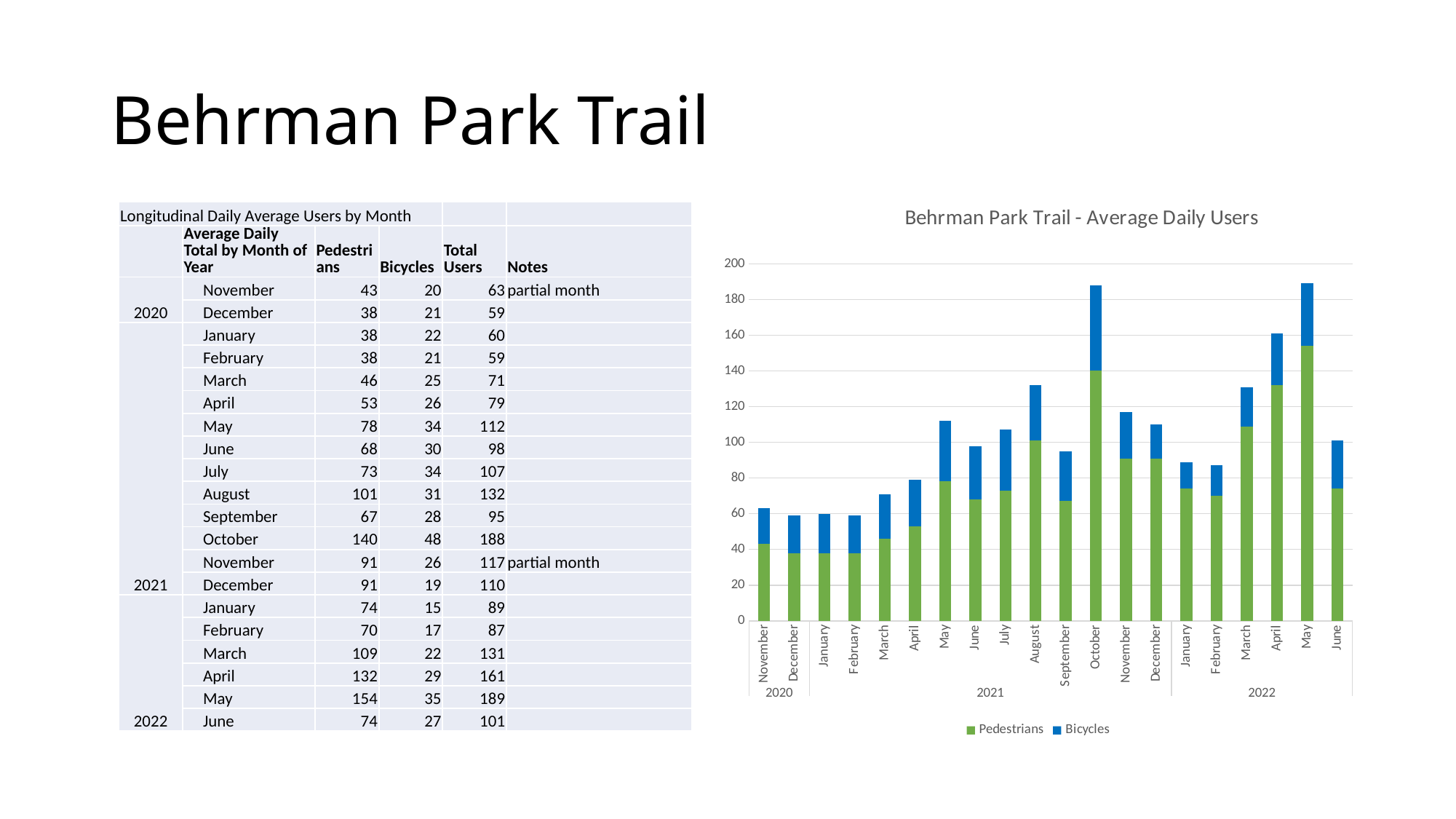
How many series does the chart legend list? 2 Is the total for September 2021 greater or less than 100? less Which month has the highest Pedestrians value in the chart? May 2022 Which is larger, the total for April 2022 or the total for November 2021? April 2022 What kind of chart is shown on the slide? stacked bar chart What is the difference between the Pedestrians values for October 2021 and September 2021? 73 What is the total average daily users for October 2021? 188 What is the Pedestrians value for May 2022? 154 Is the total for March 2022 greater or less than 120? greater How many monthly bars are plotted in the chart? 20 What is the Bicycles value for August 2021? 31 Which month has the highest Bicycles value in the chart? October 2021